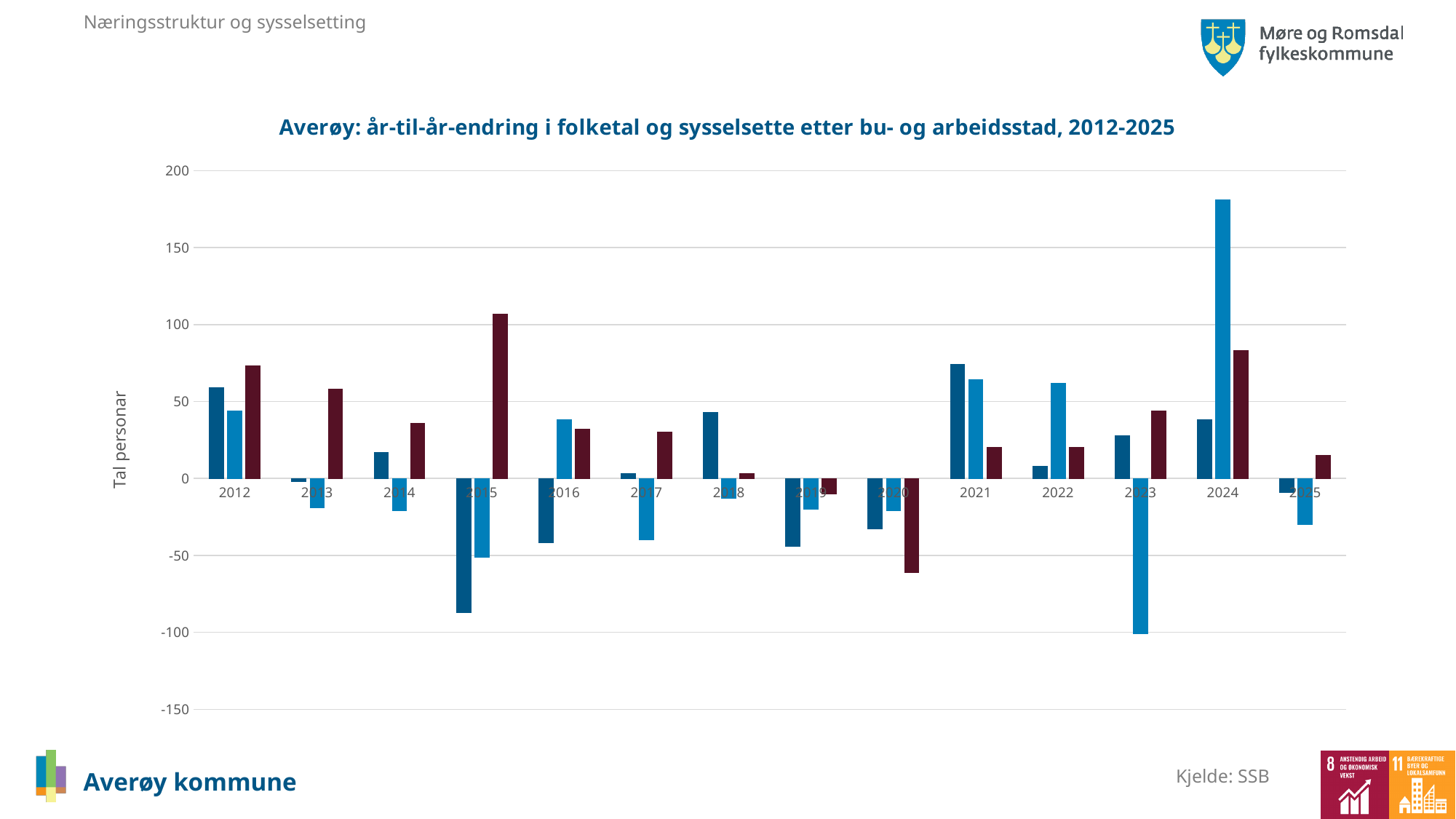
How many bars are plotted for each year in the chart? 3 In which year is the dark red bar the tallest? 2015 How many years are shown along the x axis of the chart? 14 What is the label on the vertical axis of the chart? Tal personar Is the value of the light blue bar for 2024 greater or less than 150? greater In which year is the light blue bar the tallest? 2024 What kind of chart is shown on the slide? bar chart Is the value of the dark blue bar for 2015 greater or less than -50? less In which year is the dark blue bar the lowest (most negative)? 2015 In which year is the light blue bar the lowest (most negative)? 2023 In 2012, which is larger: the dark red bar or the light blue bar? the dark red bar What source is cited for the chart data? SSB